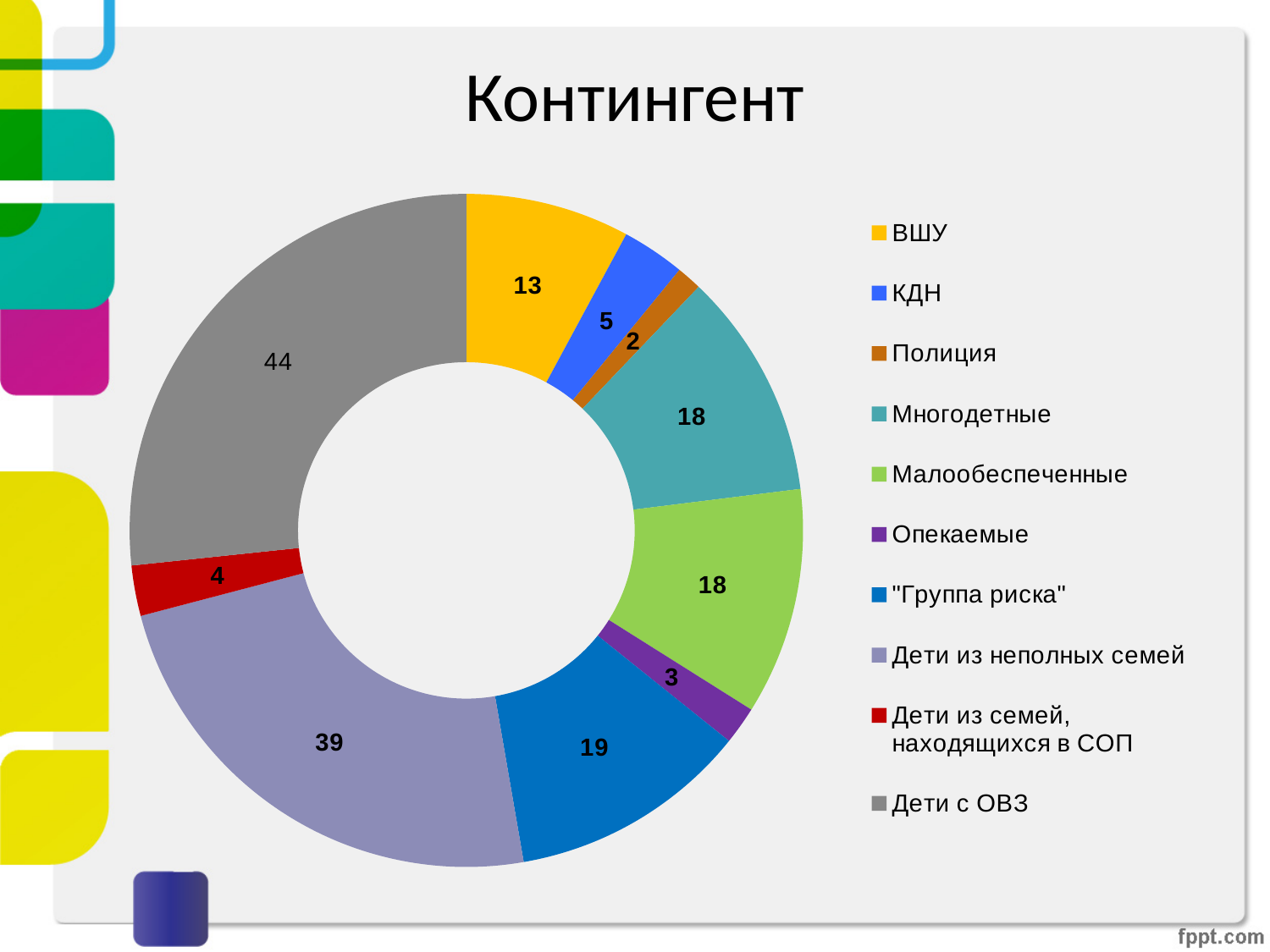
What is the value for Полиция? 2 What is the value for "Группа риска"? 19 Which category has the highest value? Дети с ОВЗ What kind of chart is shown on the slide? doughnut chart What is the difference between the values for ВШУ and КДН? 8 What is the title of the chart? Контингент What is the difference between the values for Дети с ОВЗ and Дети из неполных семей? 5 What is the value for Дети из неполных семей? 39 What is the value for Дети с ОВЗ? 44 How many categories does the chart show? 10 Which is larger, the value for Опекаемые or the value for Дети из семей, находящихся в СОП? Дети из семей, находящихся в СОП Which category has the lowest value? Полиция